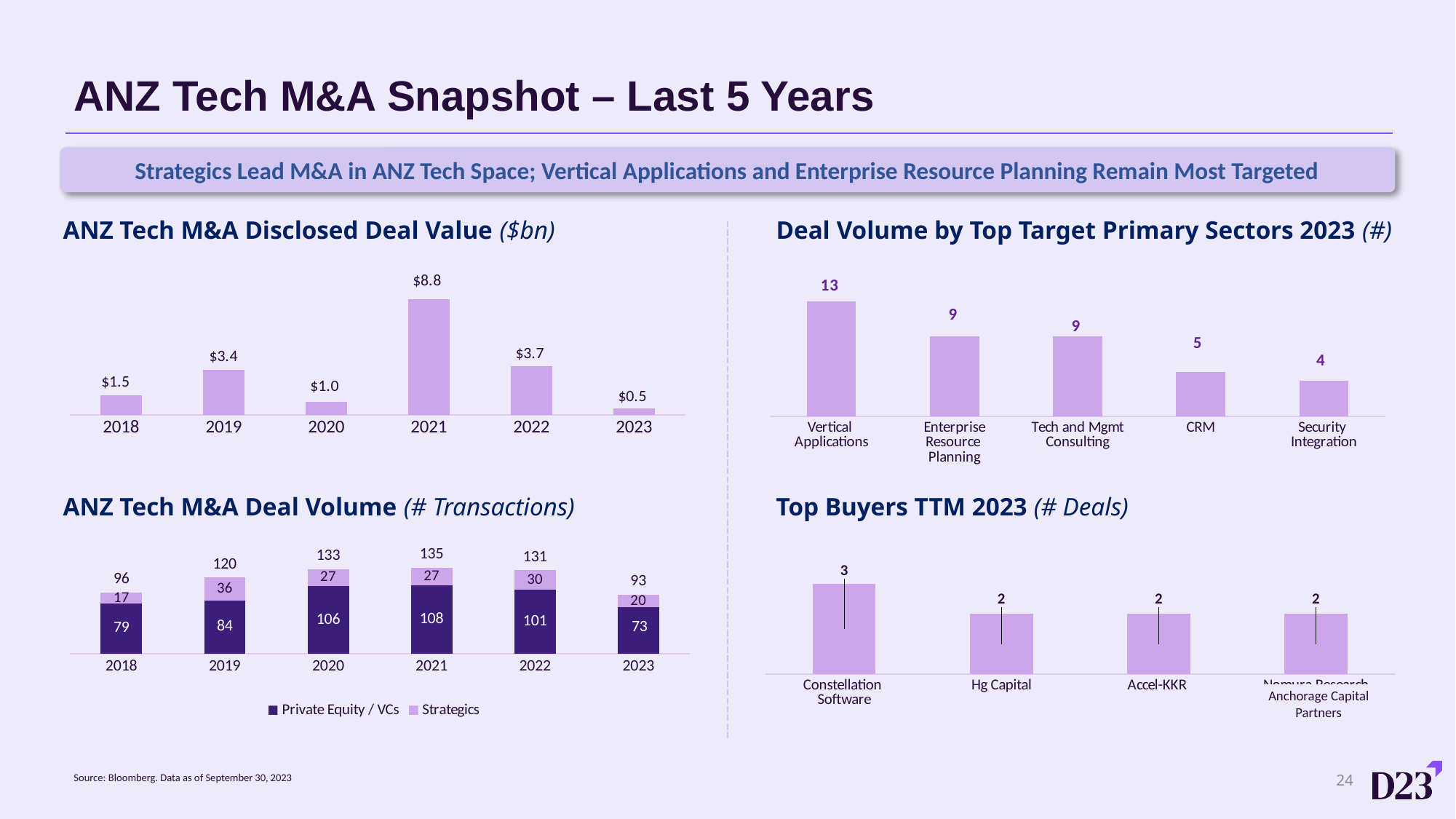
In the ANZ Tech M&A Disclosed Deal Value chart, what was the disclosed deal value in 2021? $8.8 In the ANZ Tech M&A Disclosed Deal Value chart, which year had the lowest disclosed deal value? 2023 In the ANZ Tech M&A Disclosed Deal Value chart, how many years are shown? 6 In the ANZ Tech M&A Deal Volume chart, what was the total number of transactions in 2019? 120 In the ANZ Tech M&A Deal Volume chart, what was the Strategics value in 2022? 30 In the ANZ Tech M&A Deal Volume chart, what was the Private Equity / VCs value in 2021? 108 In the Deal Volume by Top Target Primary Sectors 2023 chart, which is larger, CRM or Enterprise Resource Planning? Enterprise Resource Planning In the Deal Volume by Top Target Primary Sectors 2023 chart, how many deals were in Vertical Applications? 13 In the ANZ Tech M&A Disclosed Deal Value chart, what is the difference between the 2022 and 2020 values? $2.7 In the Deal Volume by Top Target Primary Sectors 2023 chart, which sector had the fewest deals? Security Integration In the ANZ Tech M&A Deal Volume chart, how many series does the legend list? 2 In the Top Buyers TTM 2023 chart, how many deals did Constellation Software have? 3